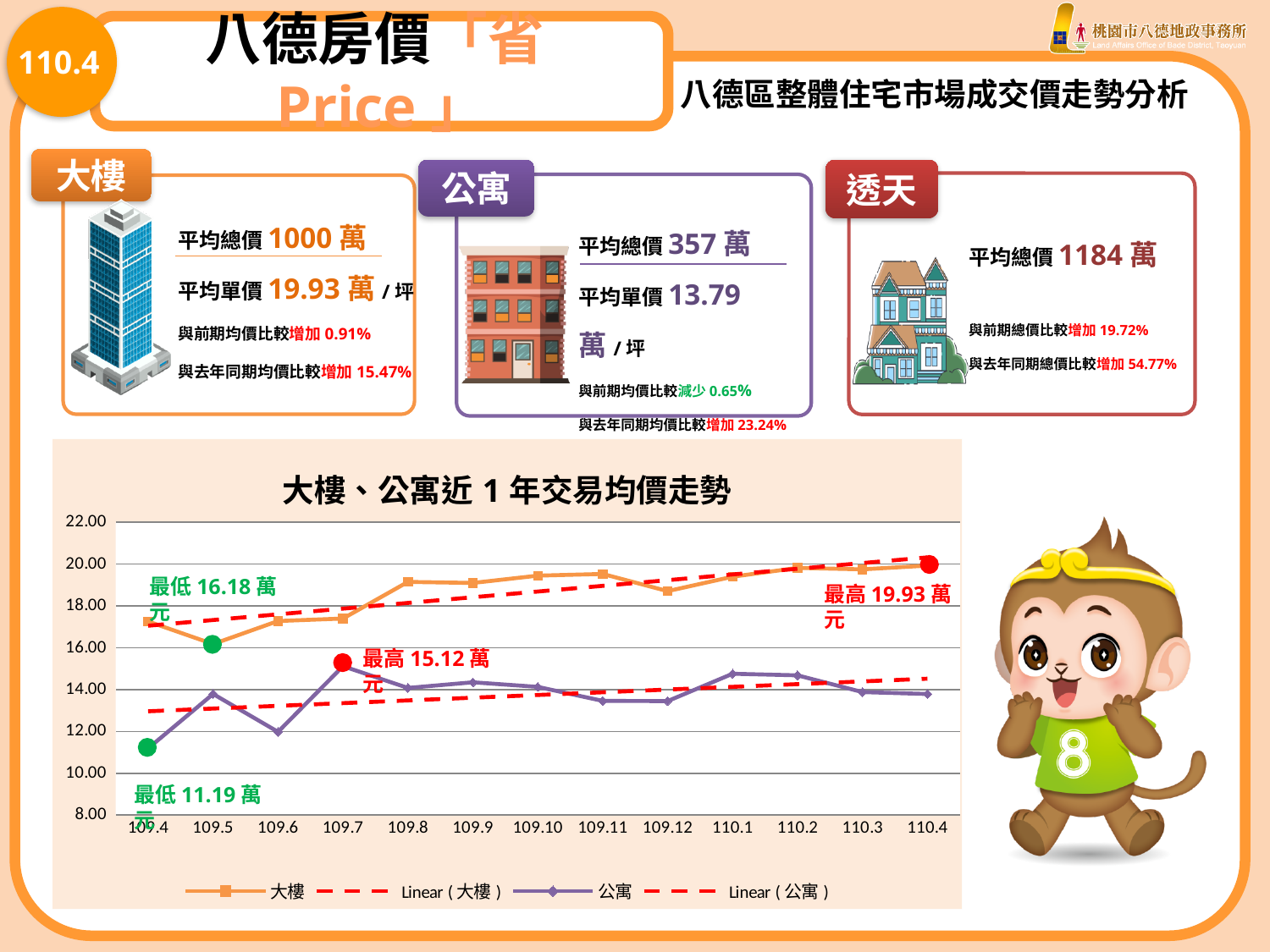
What is the lowest value of the 公寓 series, as labelled on the chart? 11.19 萬元 At which time point does the 大樓 series reach its highest value? 110.4 What kind of chart is shown on the slide? line chart Is the value of the 大樓 series at 109.8 greater or less than 18.00? greater What is the title of the chart? 大樓、公寓近 1 年交易均價走勢 At which time point does the 公寓 series reach its highest value? 109.7 How many entries does the chart legend list? 4 What is the difference between the highest (19.93 萬) and lowest (16.18 萬) labelled values of the 大樓 series? 3.75 萬 Does the 大樓 series generally rise or fall from 109.4 to 110.4? rise How many time points are plotted along the x axis of the chart? 13 At which time point does the 大樓 series reach its lowest value? 109.5 At 109.7, which series has the larger value, 大樓 or 公寓? 大樓